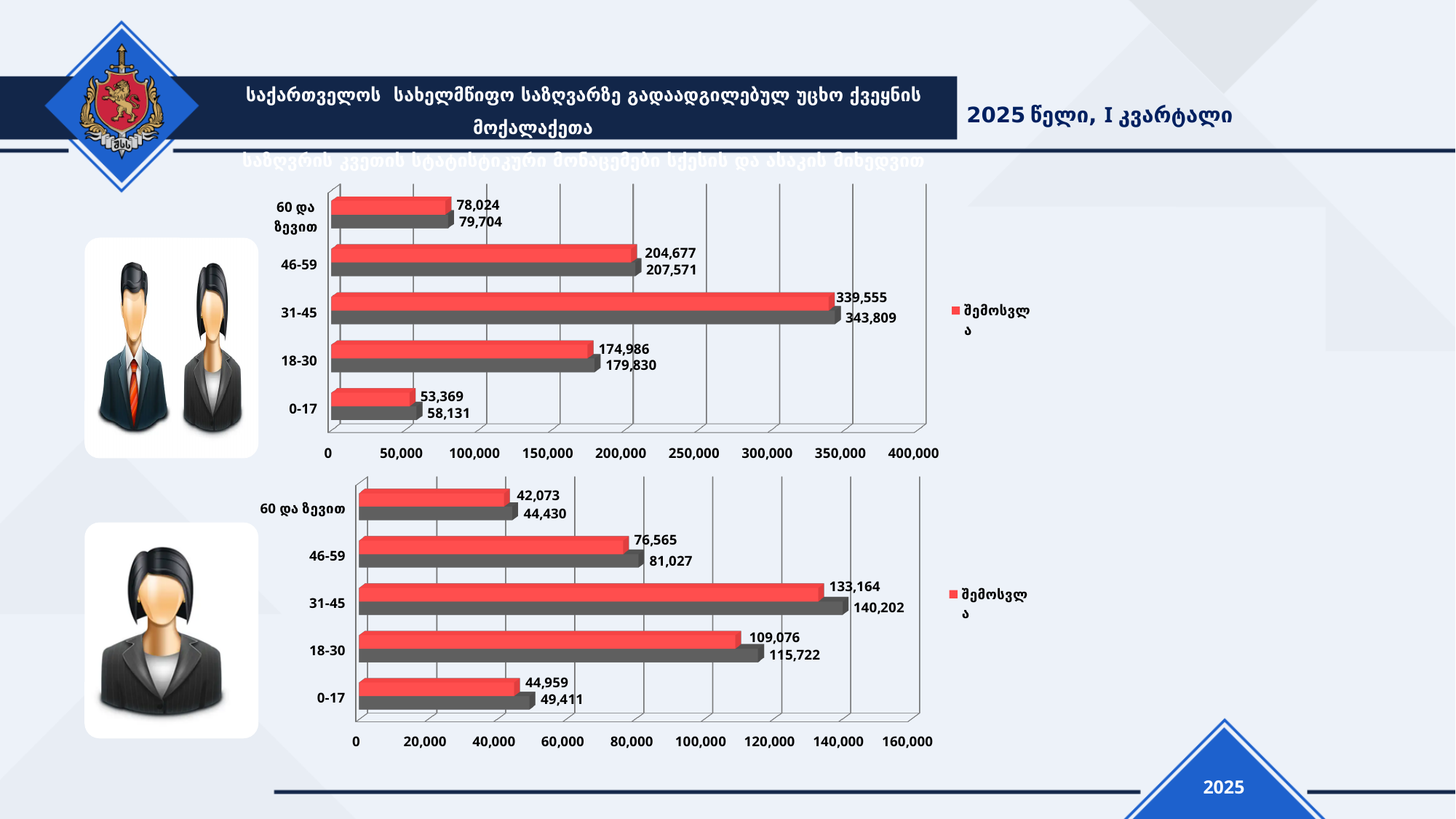
On the lower chart, what is the value of the red bar for the 18-30 age group? 109,076 On the lower chart, what is the value of the grey bar for the 31-45 age group? 140,202 On the lower chart, which age group has the lowest red-bar value? 60 და ზევით On the upper chart, what is the value of the red bar for the 31-45 age group? 339,555 On the lower chart, which is larger: the red bar for 46-59 or the red bar for 18-30? 18-30 How many age-group categories are shown on the lower chart? 5 On the upper chart, which age group has the highest red-bar value? 31-45 On the upper chart, which age group has the lowest grey-bar value? 0-17 On the upper chart, what is the difference between the grey bar and the red bar for the 46-59 age group? 2,894 On the lower chart, what is the difference between the grey bar and the red bar for the 0-17 age group? 4,452 What type of chart is the upper chart? Bar chart On the upper chart, what is the value of the grey bar for the 0-17 age group? 58,131